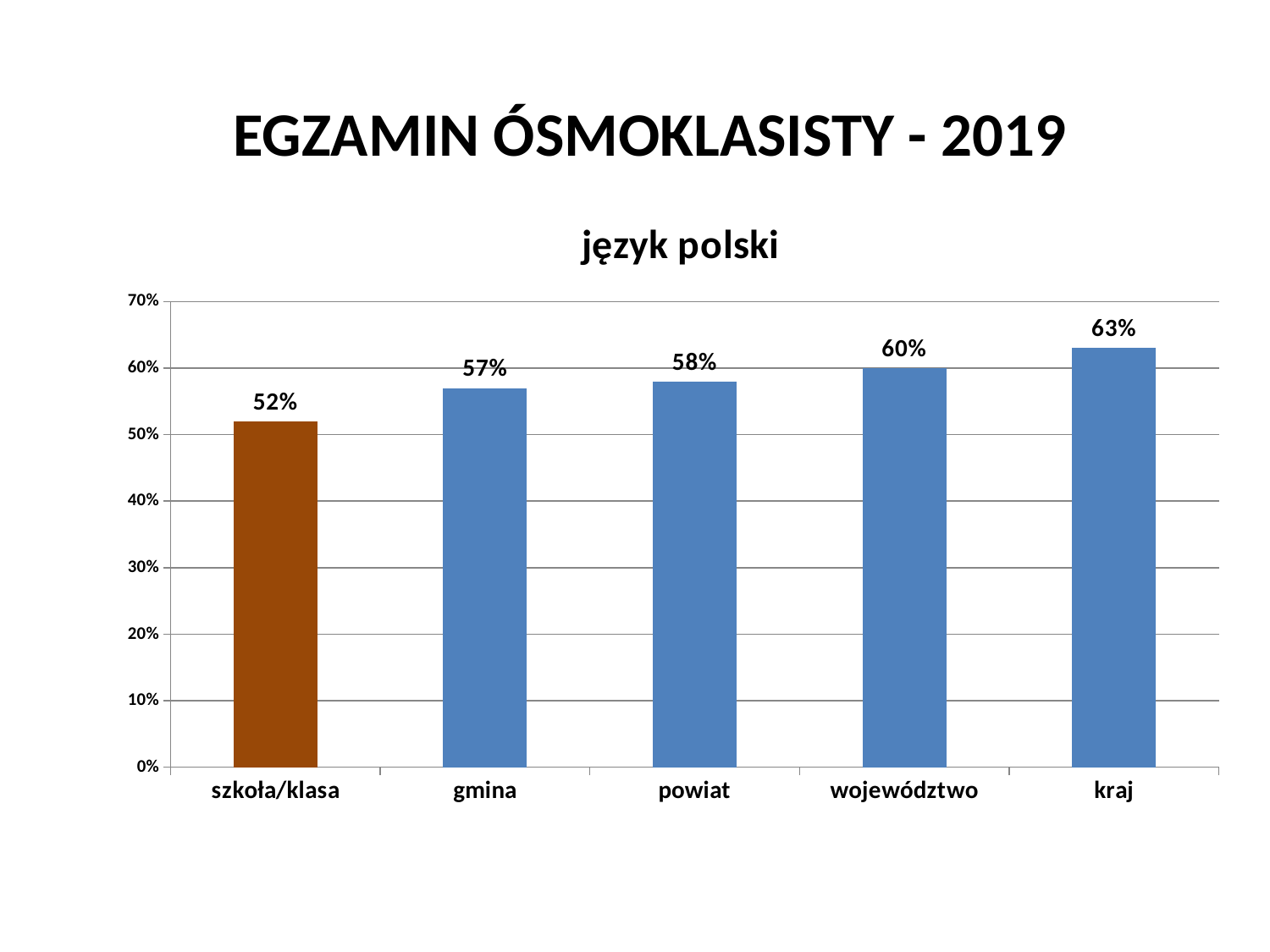
Which is larger, the value for województwo or the value for powiat? województwo What is the value for województwo? 60% What is the difference between the values for kraj and szkoła/klasa? 11% What is the value for szkoła/klasa? 52% What is the value for gmina? 57% What kind of chart is shown on the slide? bar chart Do the values rise or fall from left to right along the x axis? rise Which category has the highest value? kraj Is the value for kraj greater or less than 60%? greater How many categories are shown on the x axis? 5 Which category has the lowest value? szkoła/klasa What is the difference between the values for powiat and gmina? 1%